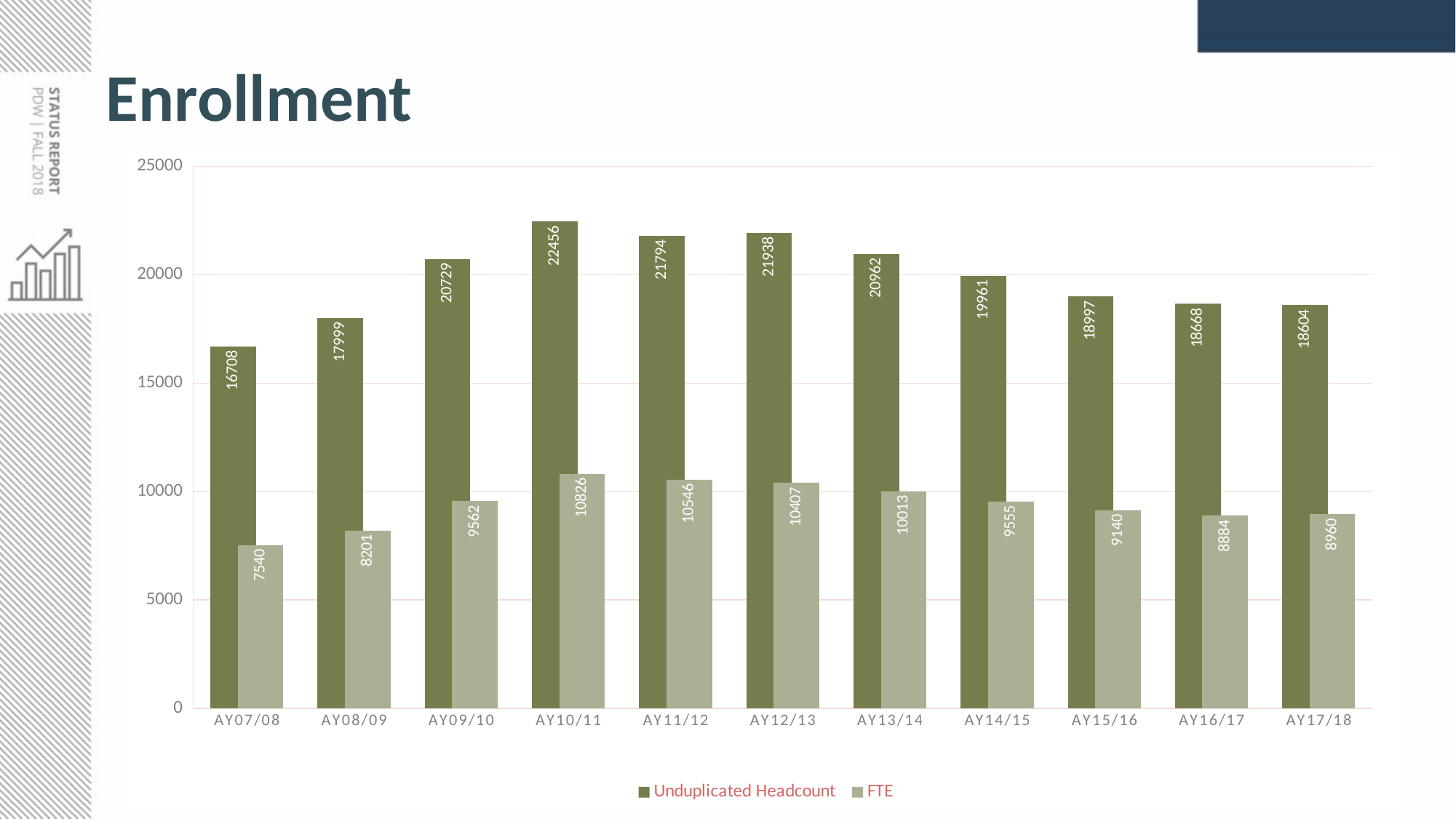
What is the difference between the Unduplicated Headcount and FTE in AY12/13? 11531 Is the Unduplicated Headcount for AY15/16 greater or less than 20000? less Which is larger, the FTE for AY16/17 or the FTE for AY17/18? AY17/18 Which academic year has the lowest FTE? AY07/08 What kind of chart is shown on the slide? bar chart What is the FTE value for AY07/08? 7540 How many series does the legend list? 2 Does the Unduplicated Headcount rise or fall from AY10/11 to AY17/18? fall What is the FTE value for AY17/18? 8960 How many academic years are shown on the x axis? 11 Which academic year has the highest Unduplicated Headcount? AY10/11 What is the Unduplicated Headcount for AY10/11? 22456